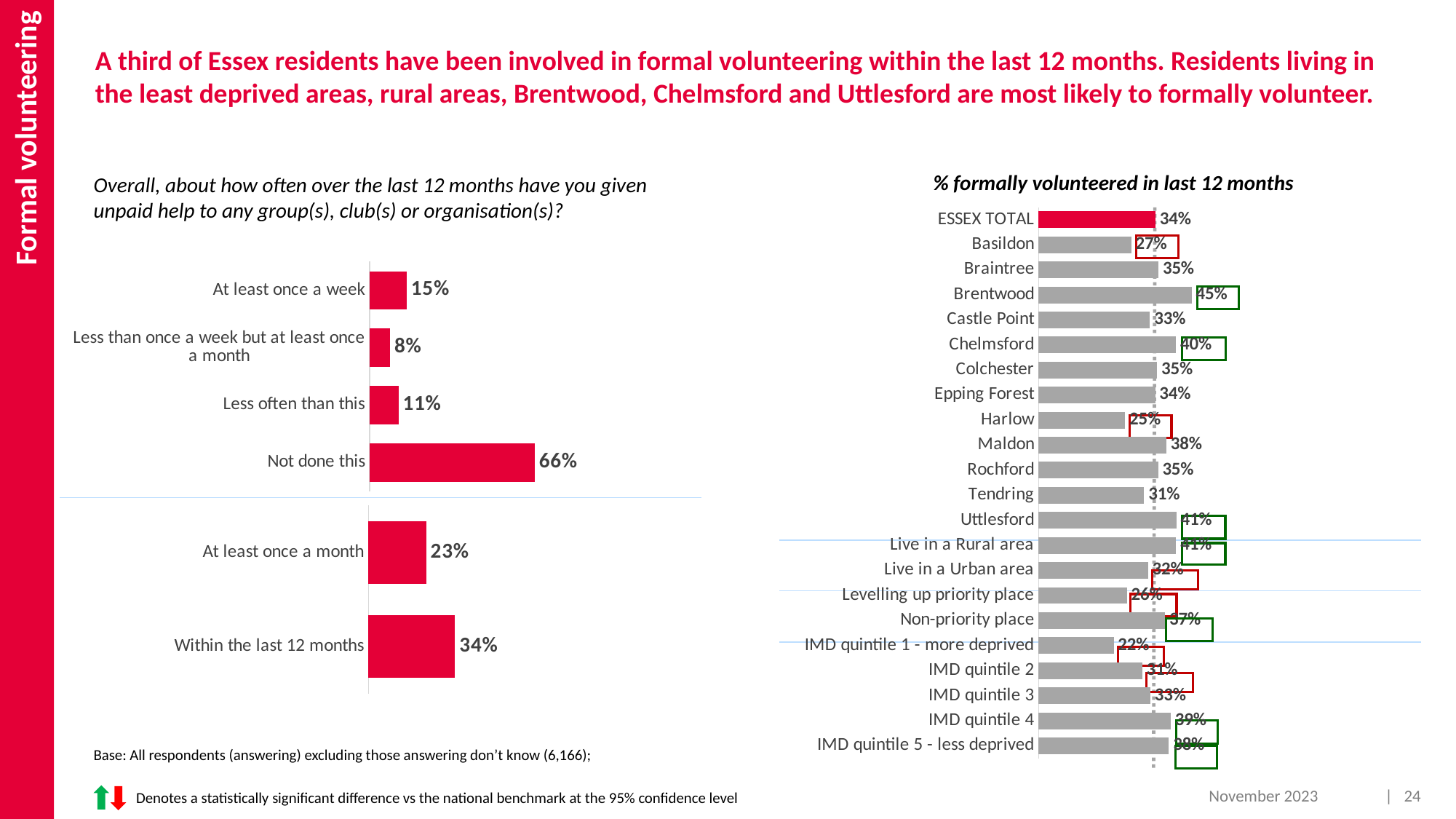
In the chart '% formally volunteered in last 12 months', what is the difference between Chelmsford and Basildon? 13% What type of chart is the '% formally volunteered in last 12 months' chart? Bar chart In the left chart on frequency of unpaid help, what is the value for 'At least once a week'? 15% In the chart '% formally volunteered in last 12 months', which category has the highest value? Brentwood In the left chart on frequency of unpaid help, which category has the lowest value? Less than once a week but at least once a month In the left chart on frequency of unpaid help, what is the difference between 'Within the last 12 months' and 'At least once a month'? 11% In the chart '% formally volunteered in last 12 months', which is larger, Maldon or Tendring? Maldon In the left chart on frequency of unpaid help, what percentage of respondents said 'Not done this'? 66% In the chart '% formally volunteered in last 12 months', how many categories are plotted? 22 In the chart '% formally volunteered in last 12 months', what is the value for ESSEX TOTAL? 34% In the chart '% formally volunteered in last 12 months', which category has the lowest value? IMD quintile 1 - more deprived In the left chart on frequency of unpaid help, how many categories are plotted? 6